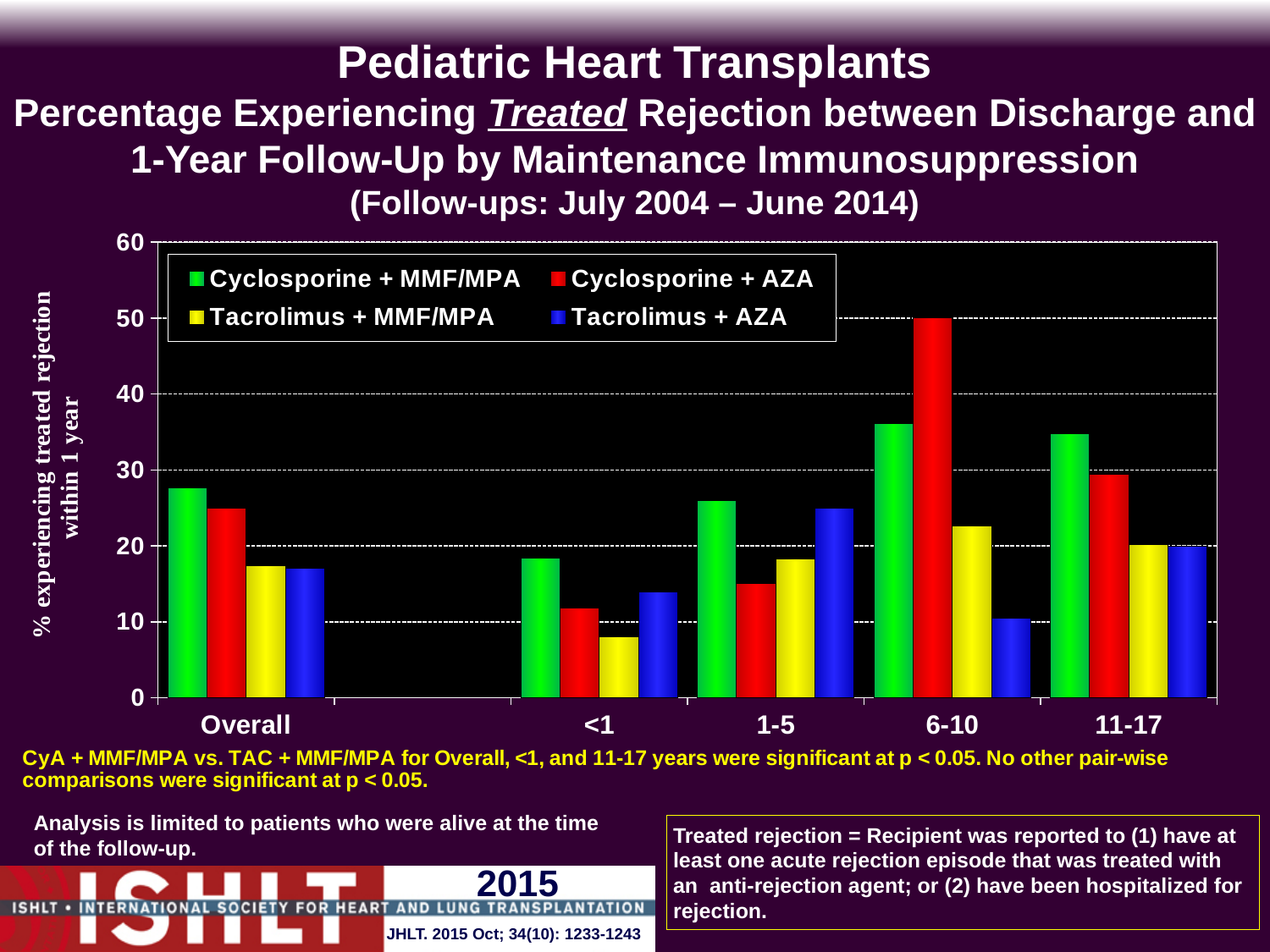
What kind of chart is shown on the slide? bar chart In the 6-10 age group, which is larger: Cyclosporine + AZA or Cyclosporine + MMF/MPA? Cyclosporine + AZA How many categories are shown along the x axis? 5 Is the value for Tacrolimus + AZA in the 6-10 age group greater or less than 20? less Which series has the lowest bar in the <1 age group? Tacrolimus + MMF/MPA How many series does the legend list? 4 Is the value for Tacrolimus + MMF/MPA in the <1 age group greater or less than 10? less Is the value for Cyclosporine + AZA in the 6-10 age group greater or less than 40? greater In the 1-5 age group, which is larger: Cyclosporine + MMF/MPA or Cyclosporine + AZA? Cyclosporine + MMF/MPA What colour represents Tacrolimus + AZA in the legend? blue Which series and age group has the highest bar in the chart? Cyclosporine + AZA, 6-10